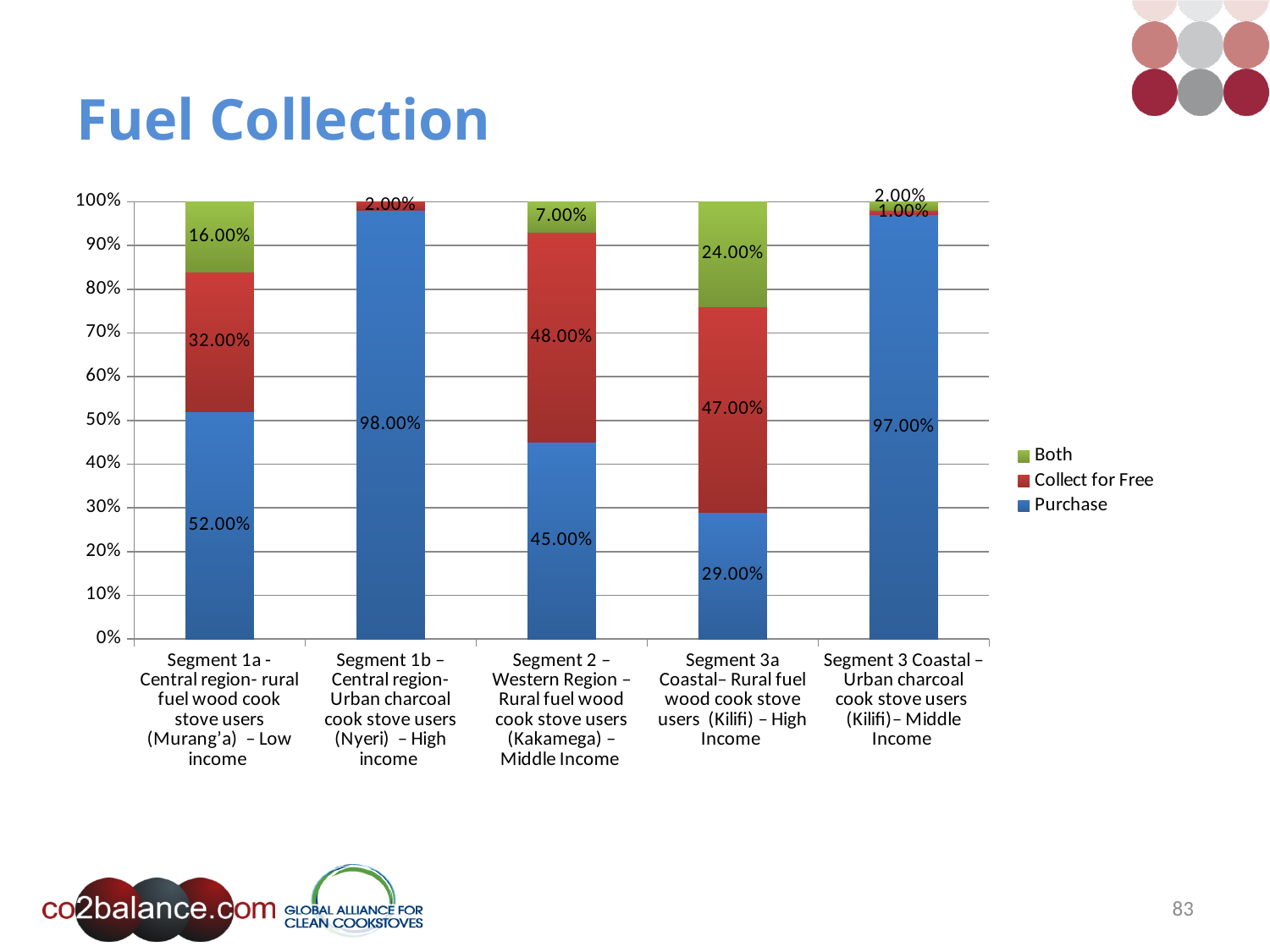
What is the difference between the Collect for Free value and the Purchase value for Segment 3a (Kilifi, High Income)? 18.00% What is the Purchase value for Segment 1a (Central region, rural fuel wood cook stove users, Murang'a, Low income)? 52.00% How many series does the legend list? 3 What is the Collect for Free value for Segment 2 (Western Region, Kakamega, Middle Income)? 48.00% What is the Both value for Segment 3a (Coastal, Rural fuel wood cook stove users, Kilifi, High Income)? 24.00% What is the title of the chart? Fuel Collection What type of chart is shown on the slide? stacked bar chart Which segment has the lowest Purchase value? Segment 3a Coastal– Rural fuel wood cook stove users (Kilifi) – High Income Which segment has the highest Purchase value? Segment 1b – Central region- Urban charcoal cook stove users (Nyeri) – High income Which is larger for Segment 2 (Kakamega, Middle Income): the Purchase value or the Collect for Free value? Collect for Free What is the Purchase value for Segment 3 Coastal (Urban charcoal cook stove users, Kilifi, Middle Income)? 97.00% How many segments (categories) are shown on the x axis? 5